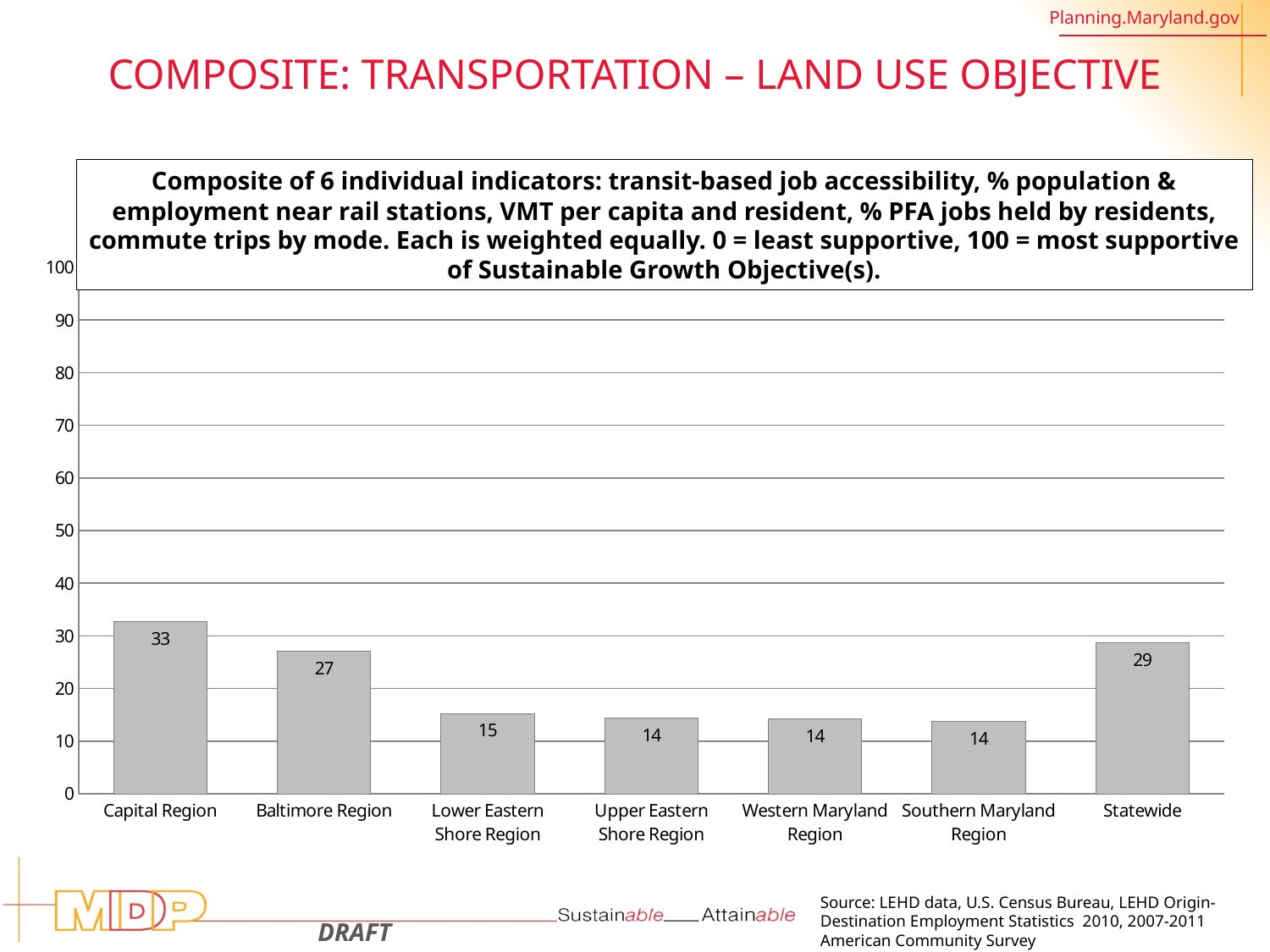
What is the value for the Capital Region? 33 Which is larger, the value for the Baltimore Region or the value for Statewide? Statewide What is the value for the Baltimore Region? 27 Is the value for the Capital Region greater or less than 30? greater What is the value for Statewide? 29 How many categories are shown on the x axis? 7 What kind of chart is shown on the slide? bar chart What is the value for the Lower Eastern Shore Region? 15 How many regions have a value of 14? 3 What is the difference between the Capital Region and the Baltimore Region values? 6 Which region has the highest value? Capital Region What is the difference between the Statewide value and the Western Maryland Region value? 15